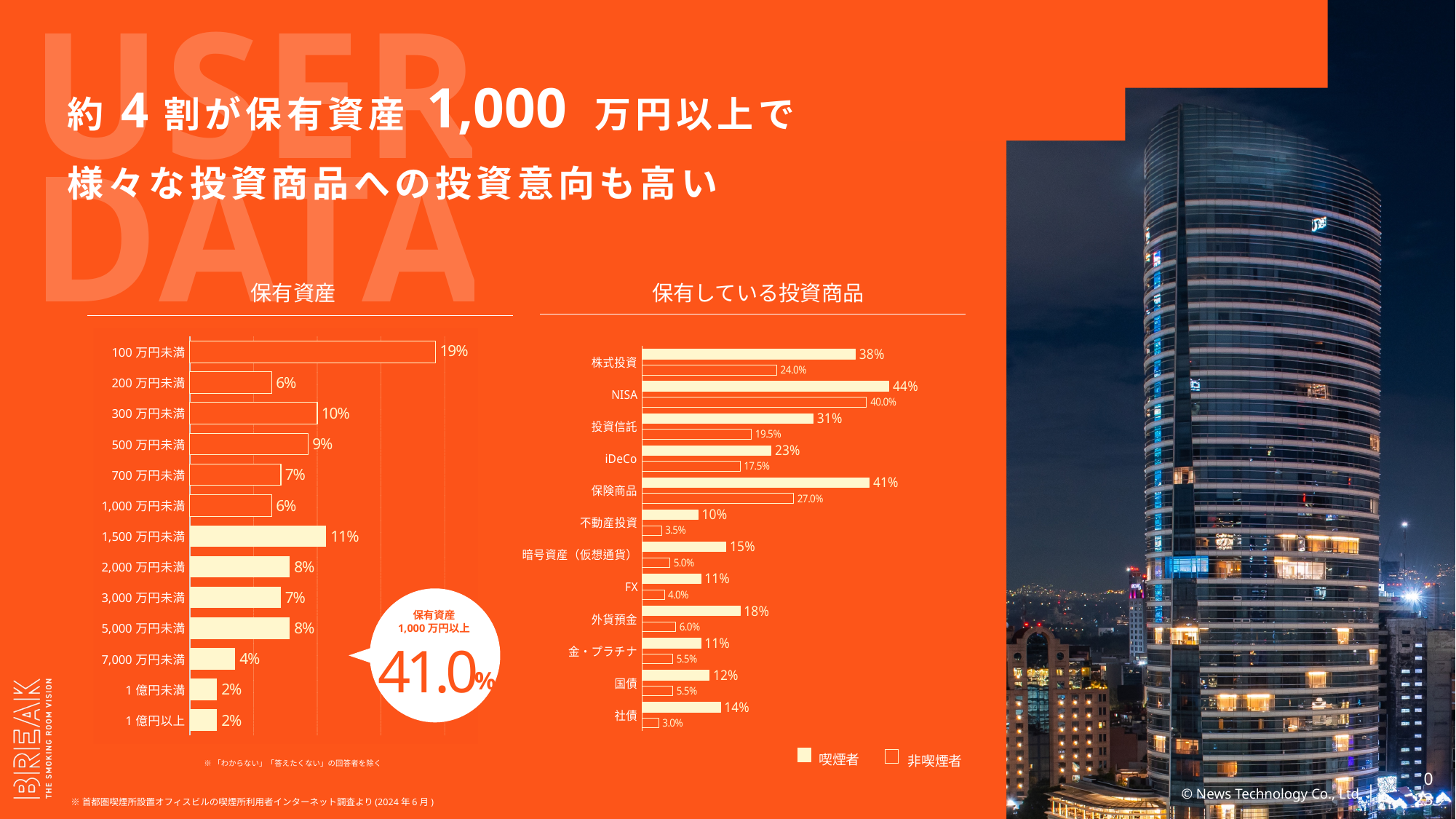
In the 保有している投資商品 chart, which category has the lowest 非喫煙者 value? 社債 In the 保有している投資商品 chart, what is the 喫煙者 value for NISA? 44% How many series does the legend of the 保有している投資商品 chart list? 2 How many categories does the 保有資産 chart show? 13 What kind of chart is the 保有資産 chart? bar chart In the 保有資産 chart, what is the value for 100万円未満? 19% In the 保有資産 chart, what is the difference between the values for 1,500万円未満 and 7,000万円未満? 7% In the 保有している投資商品 chart, what is the 非喫煙者 value for 保険商品? 27.0% How many categories does the 保有している投資商品 chart show? 12 In the 保有している投資商品 chart, which is larger for 株式投資: the 喫煙者 value or the 非喫煙者 value? 喫煙者 In the 保有資産 chart, which category has the highest value? 100万円未満 In the 保有している投資商品 chart, what is the difference between the 喫煙者 and 非喫煙者 values for 投資信託? 11.5%